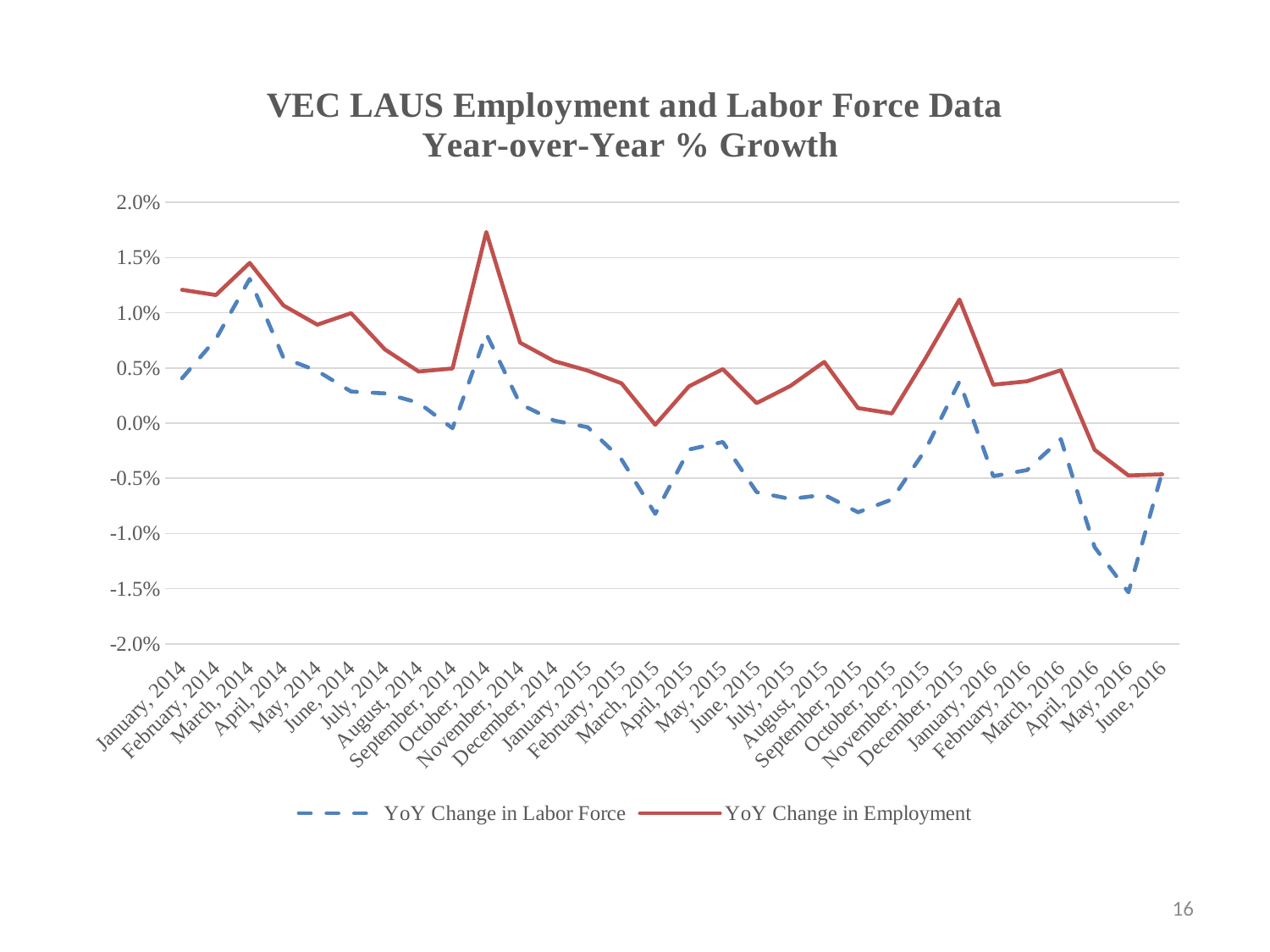
Is the YoY Change in Employment for October, 2014 greater or less than 1.5%? greater In which month does the YoY Change in Employment reach its highest value? October, 2014 In October, 2014, which series has the larger value: YoY Change in Labor Force or YoY Change in Employment? YoY Change in Employment Is the YoY Change in Labor Force for May, 2016 greater or less than -1.0%? less In which month does the YoY Change in Labor Force reach its lowest value? May, 2016 Is the YoY Change in Employment for January, 2014 greater or less than 1.0%? greater How many monthly data points are plotted along the x axis? 30 How many series does the legend list? 2 What kind of chart is shown on the slide? Line chart In which month does the YoY Change in Labor Force reach its highest value? March, 2014 Which series is drawn with a dashed line? YoY Change in Labor Force